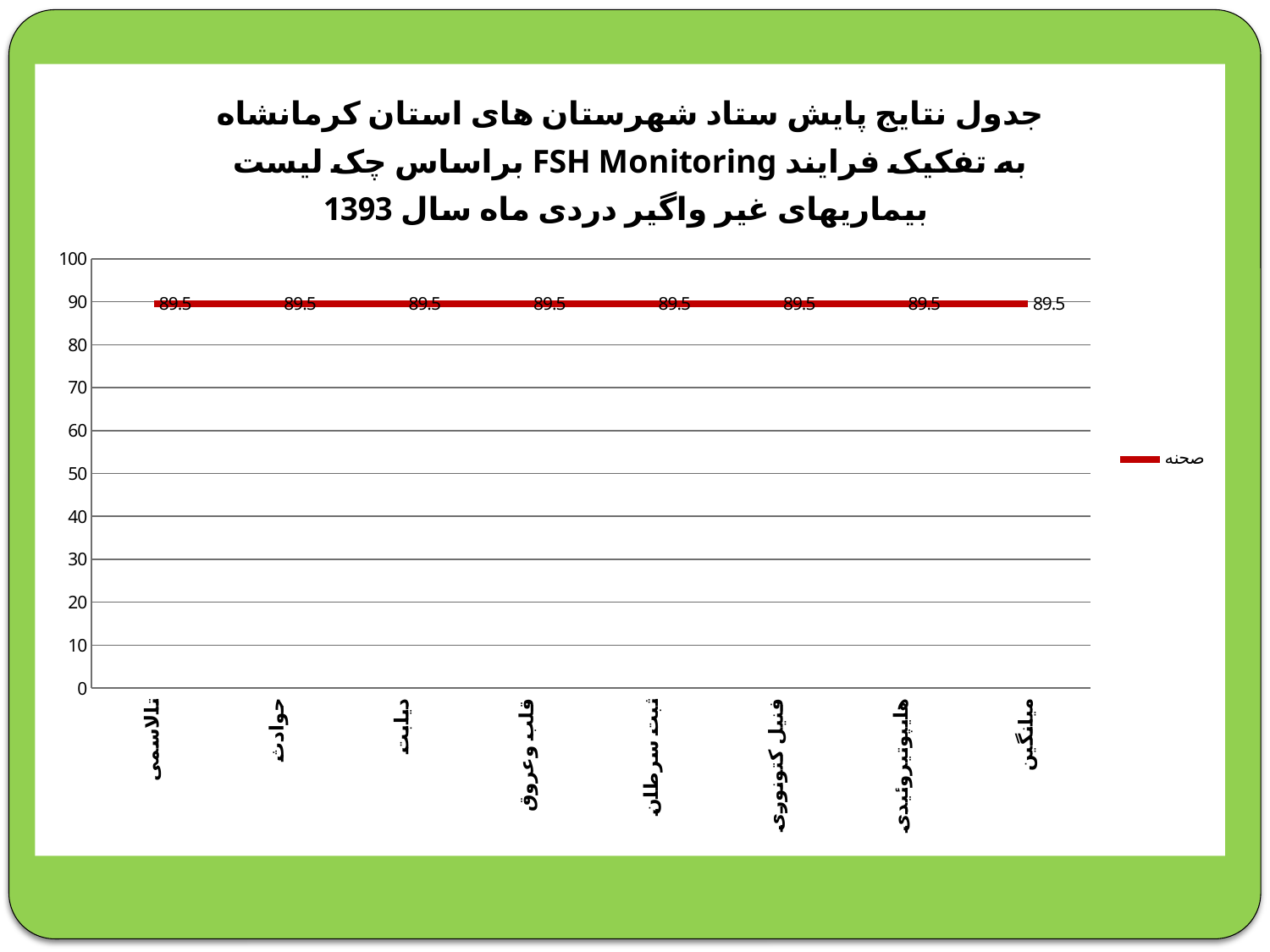
Is the value for قلب و عروق greater or less than 80? greater Do the values rise, fall, or stay the same across the categories? stay the same What is the value for میانگین? 89.5 What is the difference between the values for حوادث and ثبت سرطان? 0 What is the value for فنیل کتونوری? 89.5 What is the value for تالاسمی? 89.5 How many categories are shown on the x axis? 8 Is the value for هیپوتیروئیدی greater or less than 90? less What kind of chart is shown on the slide? line chart What is the name of the series shown in the legend? صحنه What is the value for دیابت? 89.5 How many series does the legend list? 1